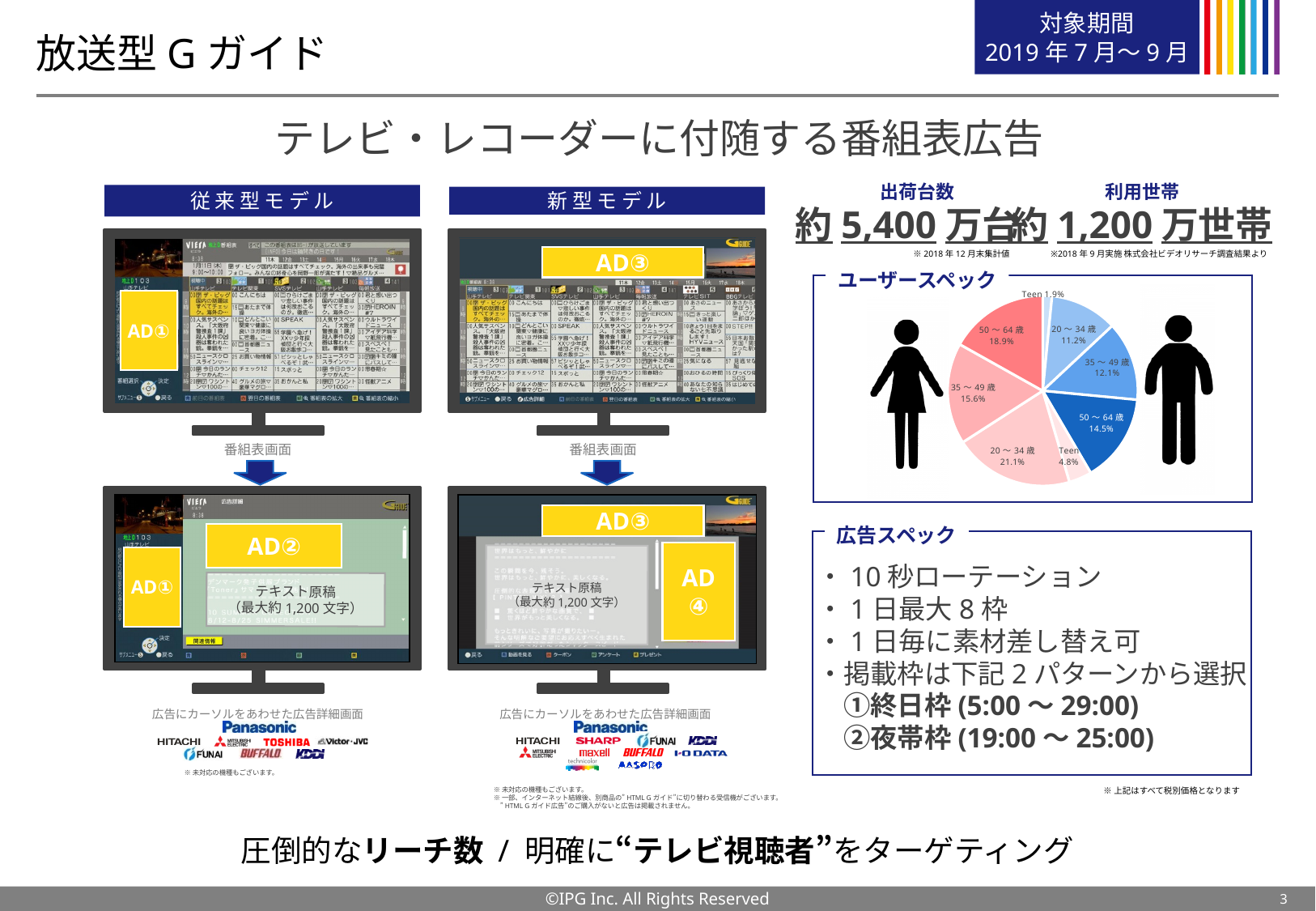
What kind of chart is shown in the ユーザースペック section? pie chart In the ユーザースペック pie chart, what is the share of the dark blue 50～64歳 slice? 14.5% In the ユーザースペック pie chart, what is the share of the blue 35～49歳 slice? 12.1% What is the percentage of the smallest slice in the ユーザースペック pie chart? 1.9% Which slice is the smallest in the ユーザースペック pie chart? Teen (1.9%) In the ユーザースペック pie chart, what is the share of the red 50～64歳 slice? 18.9% In the ユーザースペック pie chart, which is larger: the blue 50～64歳 slice (14.5%) or the blue 35～49歳 slice (12.1%)? the blue 50～64歳 slice (14.5%) Which slice is the largest in the ユーザースペック pie chart? 20～34歳 (21.1%) In the ユーザースペック pie chart, what is the difference between the 21.1% slice and the 18.9% slice? 2.2 percentage points What is the percentage of the largest slice in the ユーザースペック pie chart? 21.1% How many slices does the ユーザースペック pie chart have? 8 What is the title of the section containing the pie chart? ユーザースペック